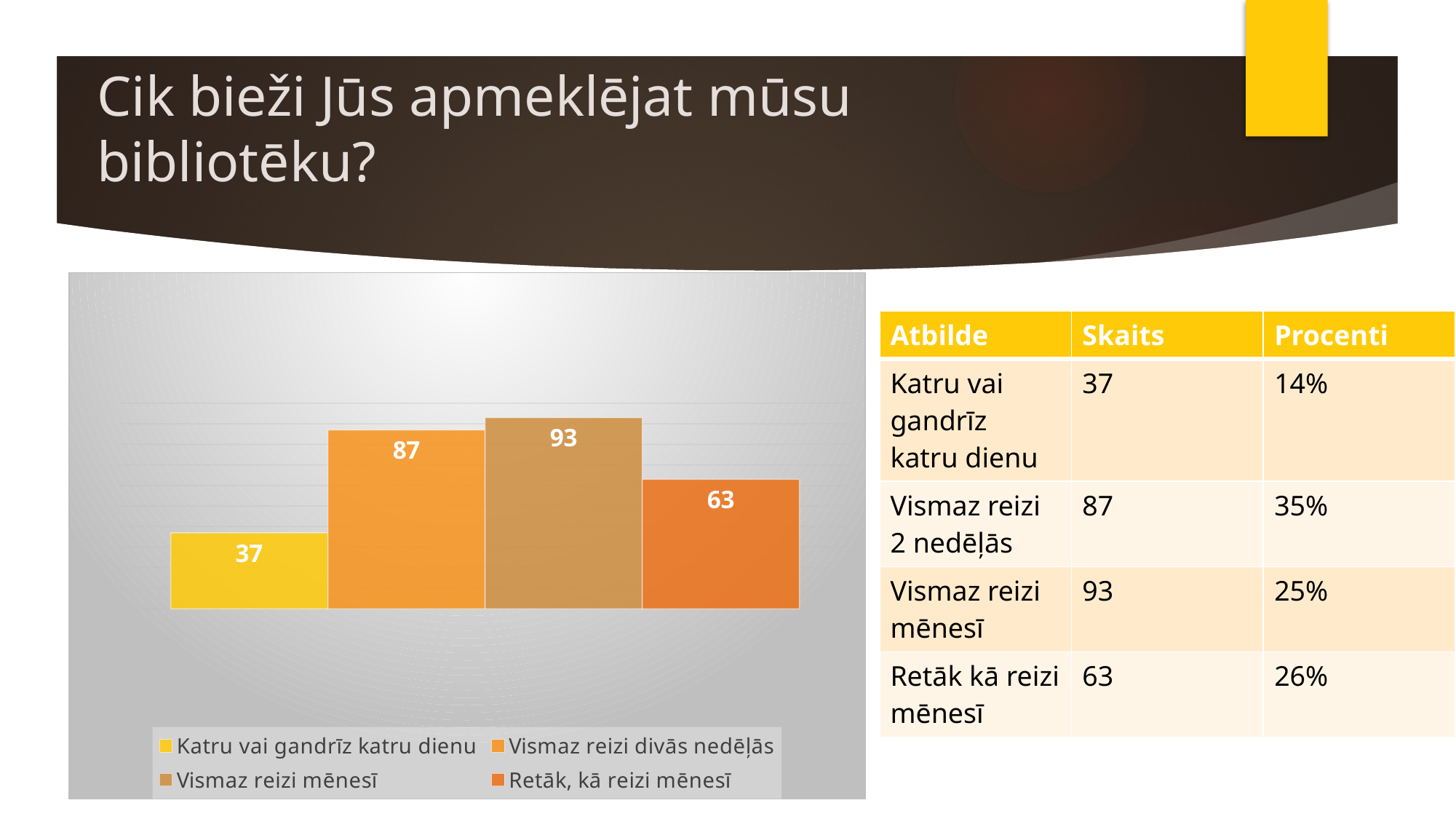
What is the value of the bar for "Vismaz reizi divās nedēļās"? 87 What is the value of the bar for "Retāk, kā reizi mēnesī"? 63 What is the value of the bar for "Vismaz reizi mēnesī"? 93 Which legend entry has the lowest bar in the chart? Katru vai gandrīz katru dienu Which legend entry has the highest bar in the chart? Vismaz reizi mēnesī What kind of chart is shown on the slide? Bar chart What is the value of the bar for "Katru vai gandrīz katru dienu"? 37 How many series does the chart legend list? 4 Which bar is larger: "Vismaz reizi divās nedēļās" or "Retāk, kā reizi mēnesī"? Vismaz reizi divās nedēļās What is the difference between the bars for "Vismaz reizi divās nedēļās" and "Retāk, kā reizi mēnesī"? 24 What colour is the bar for "Katru vai gandrīz katru dienu"? Yellow What is the difference between the bars for "Vismaz reizi mēnesī" and "Katru vai gandrīz katru dienu"? 56